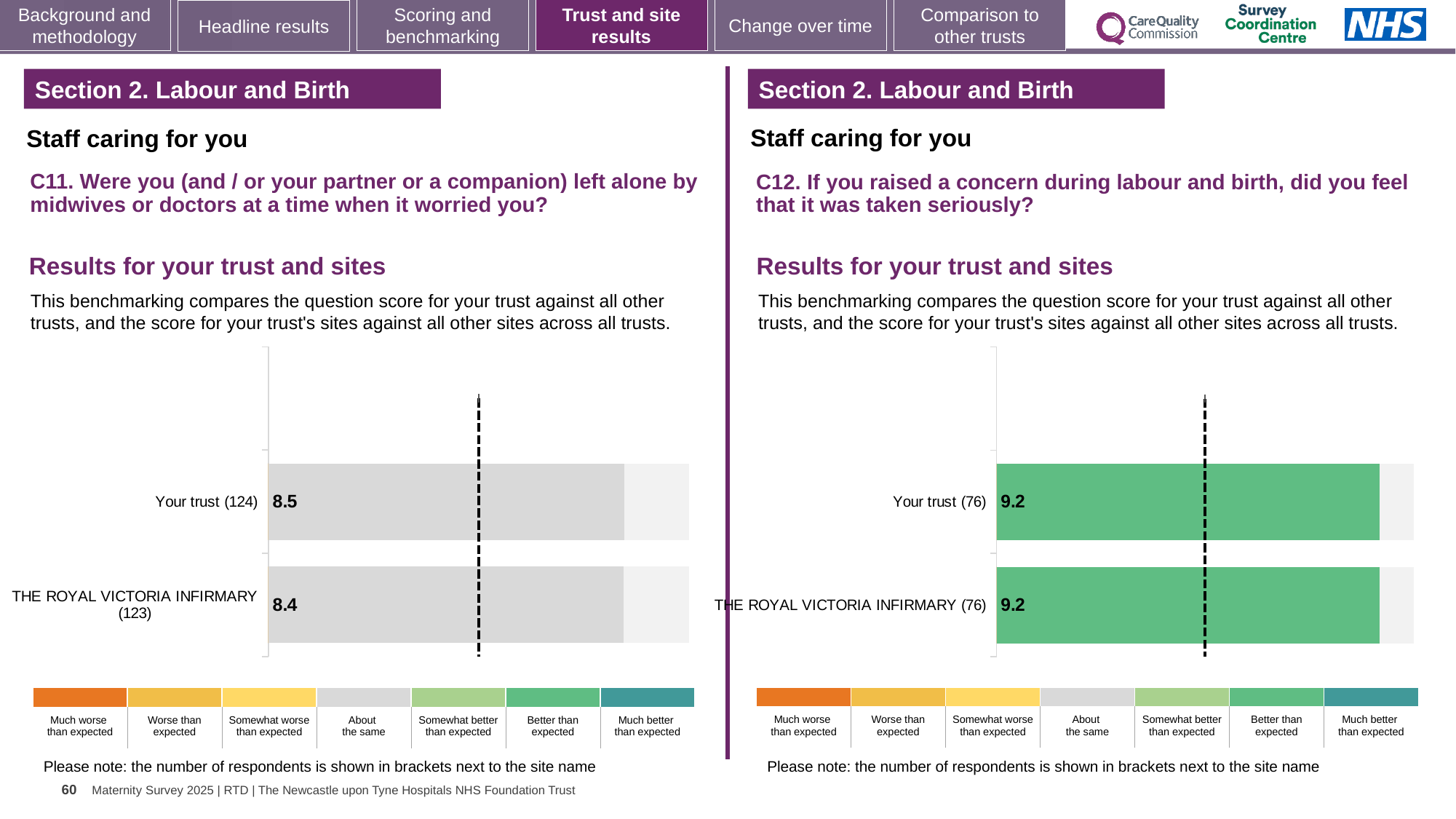
What kind of chart is used on the right (C12)? Bar chart On the right chart (C12), what is the score for Your trust? 9.2 On the left chart (C11), what is the score for THE ROYAL VICTORIA INFIRMARY? 8.4 On the right chart (C12), how many respondents are shown in brackets for THE ROYAL VICTORIA INFIRMARY? 76 On the left chart (C11), which has the higher score, Your trust or THE ROYAL VICTORIA INFIRMARY? Your trust On the right chart (C12), what is the score for THE ROYAL VICTORIA INFIRMARY? 9.2 On the left chart (C11), what is the score for Your trust? 8.5 On the right chart (C12), which benchmark category does the colour of the bars correspond to according to the legend? Better than expected On the left chart (C11), which benchmark category does the colour of the bars correspond to according to the legend? About the same On the left chart (C11), what is the difference between the score for Your trust and the score for THE ROYAL VICTORIA INFIRMARY? 0.1 How many bars are plotted on the left chart (C11)? 2 On the left chart (C11), how many respondents are shown in brackets for Your trust? 124